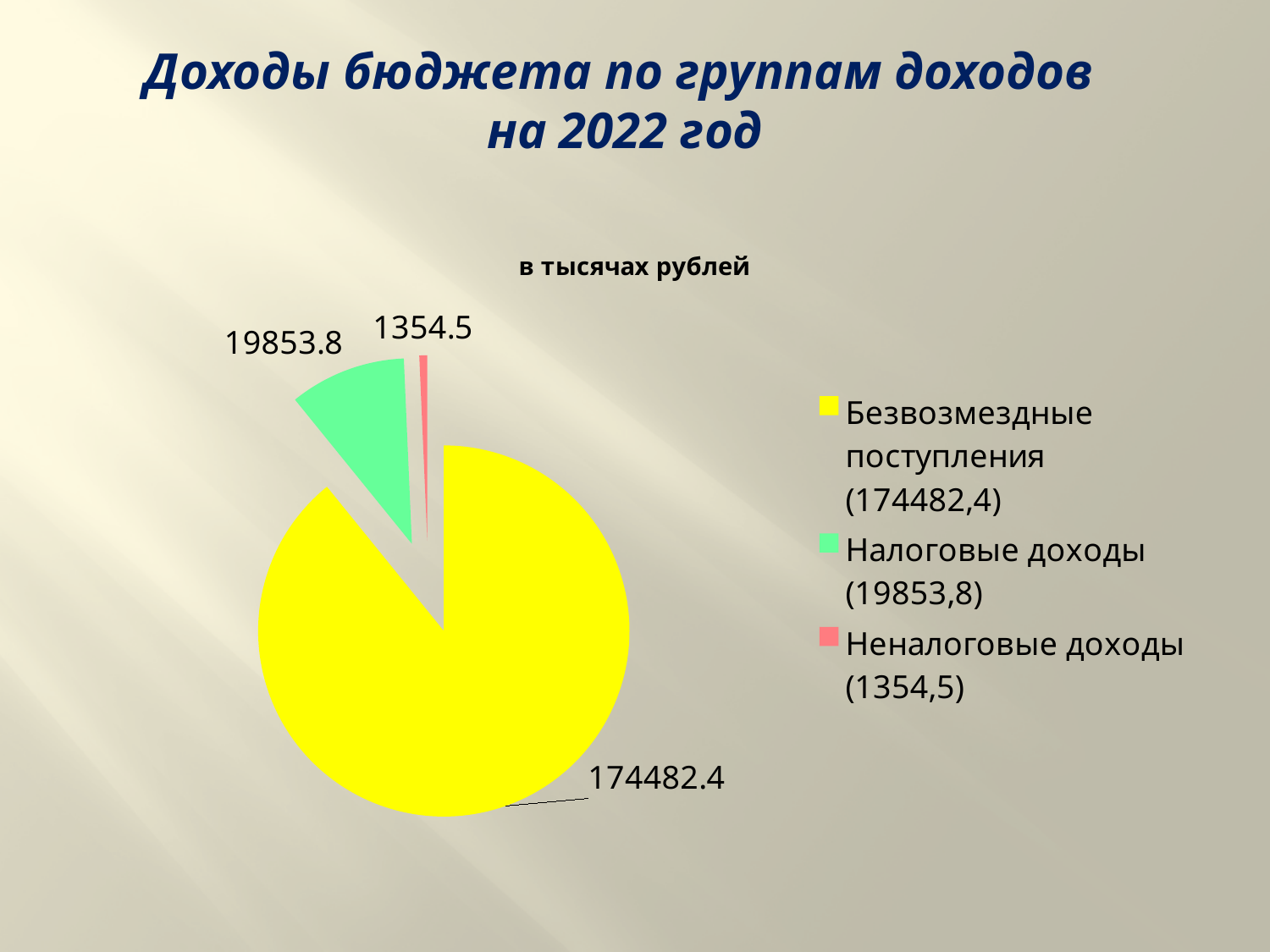
Which category has the smallest slice of the pie? Неналоговые доходы What is the value for Налоговые доходы? 19853.8 What kind of chart is shown on the slide? pie chart What is the value for Неналоговые доходы? 1354.5 What is the difference between Безвозмездные поступления and Налоговые доходы? 154628.6 What is the title of the chart? в тысячах рублей What colour is the slice for Налоговые доходы? green Which category has the largest slice of the pie? Безвозмездные поступления What is the value for Безвозмездные поступления? 174482.4 What is the difference between Налоговые доходы and Неналоговые доходы? 18499.3 Which is larger, Налоговые доходы or Неналоговые доходы? Налоговые доходы How many slices does the pie chart have? 3